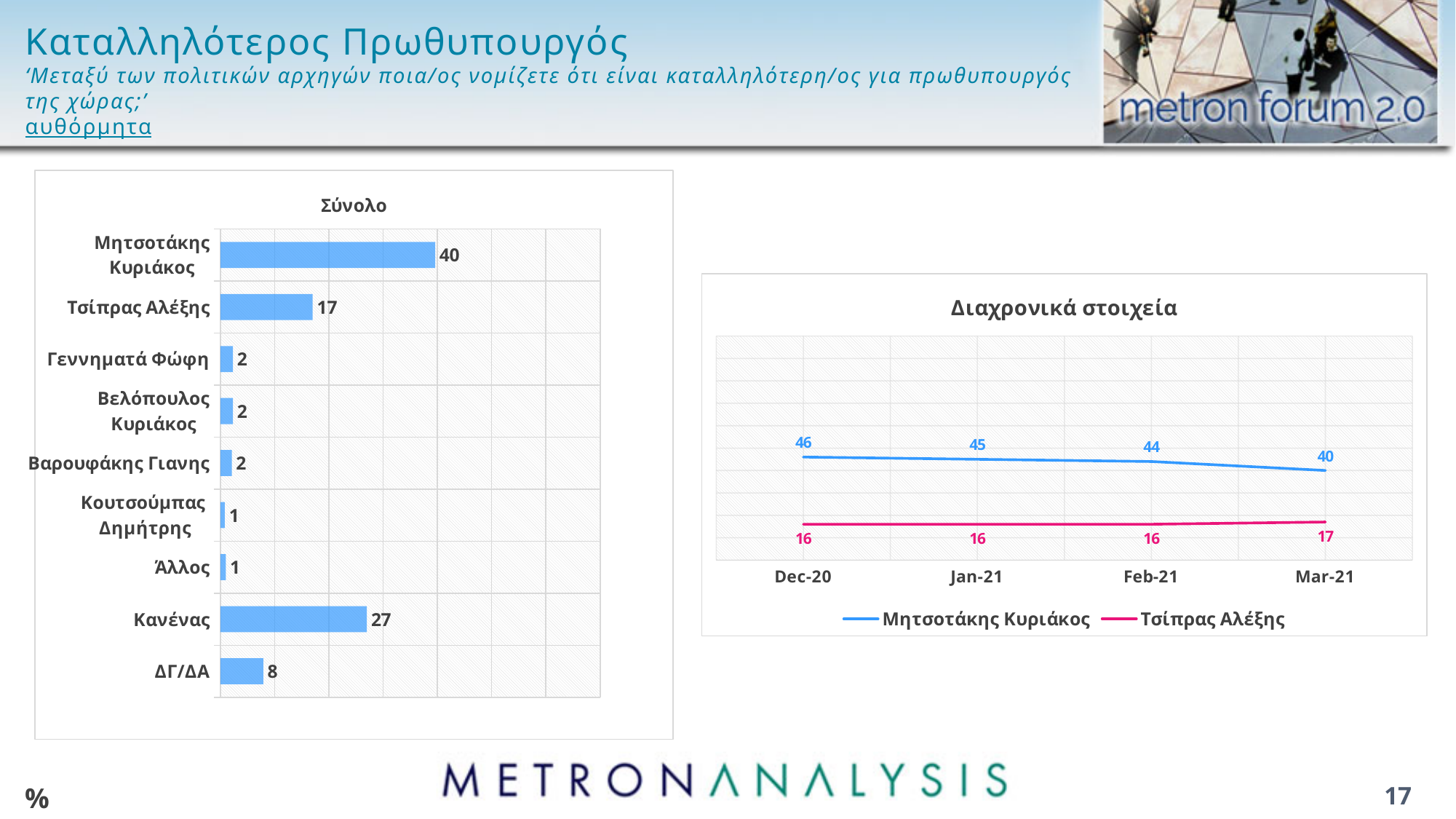
What kind of chart is the 'Σύνολο' chart? Bar chart In the 'Σύνολο' chart, what is the value for Μητσοτάκης Κυριάκος? 40 In the 'Σύνολο' chart, which category has the highest value? Μητσοτάκης Κυριάκος How many series does the legend of the 'Διαχρονικά στοιχεία' chart list? 2 In the 'Διαχρονικά στοιχεία' chart, does the Μητσοτάκης Κυριάκος series rise or fall from Dec-20 to Mar-21? Fall In the 'Διαχρονικά στοιχεία' chart, what is the value for Τσίπρας Αλέξης in Mar-21? 17 In the 'Σύνολο' chart, what is the value for Κανένας? 27 In the 'Σύνολο' chart, which is larger: the value for Κανένας or the value for Τσίπρας Αλέξης? Κανένας In the 'Σύνολο' chart, how many categories are shown? 9 In the 'Διαχρονικά στοιχεία' chart, what is the difference between Μητσοτάκης Κυριάκος and Τσίπρας Αλέξης in Feb-21? 28 In the 'Διαχρονικά στοιχεία' chart, what is the value for Μητσοτάκης Κυριάκος in Dec-20? 46 In the 'Σύνολο' chart, what is the difference between the values for Μητσοτάκης Κυριάκος and Τσίπρας Αλέξης? 23